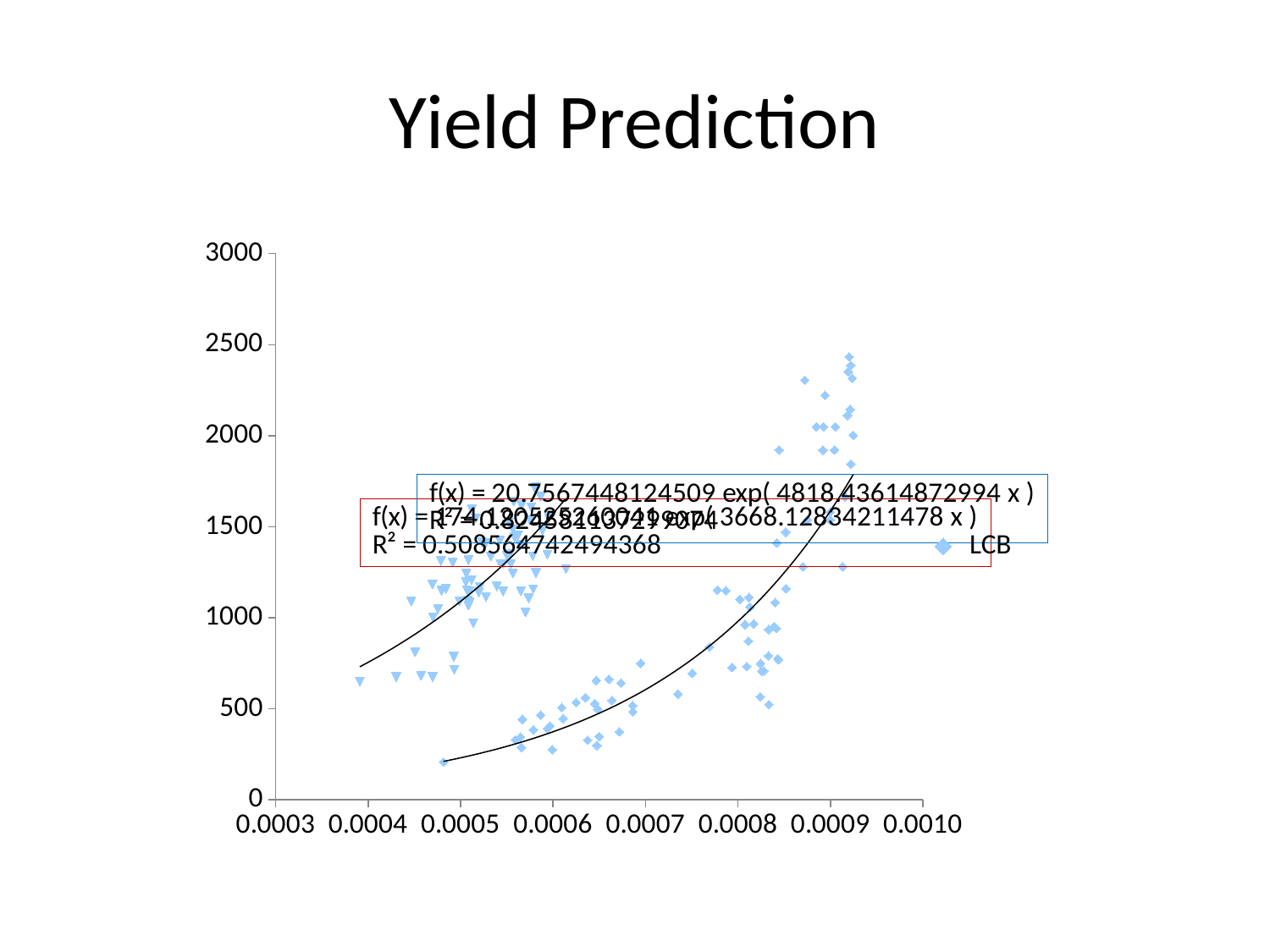
What is the highest tick value shown on the y axis? 3000 What is the R² value shown in the lower trendline label? 0.508564742494368 What is the exponent coefficient in the lower trendline equation ending in exp( ... x )? 3668.12834211478 What kind of chart is shown on the slide? scatter chart What is the exponent coefficient in the upper trendline equation f(x) = 20.7567448124509 exp( ... x )? 4818.43614872994 Is the lowest plotted point on the chart greater or less than 500? less Do the plotted values generally rise or fall as x increases along the x axis? rise What is the multiplying constant in the upper trendline equation? 20.7567448124509 What is the title of the chart? Yield Prediction Is the highest plotted point on the chart greater or less than 2000? greater What is the lowest tick value shown on the x axis? 0.0003